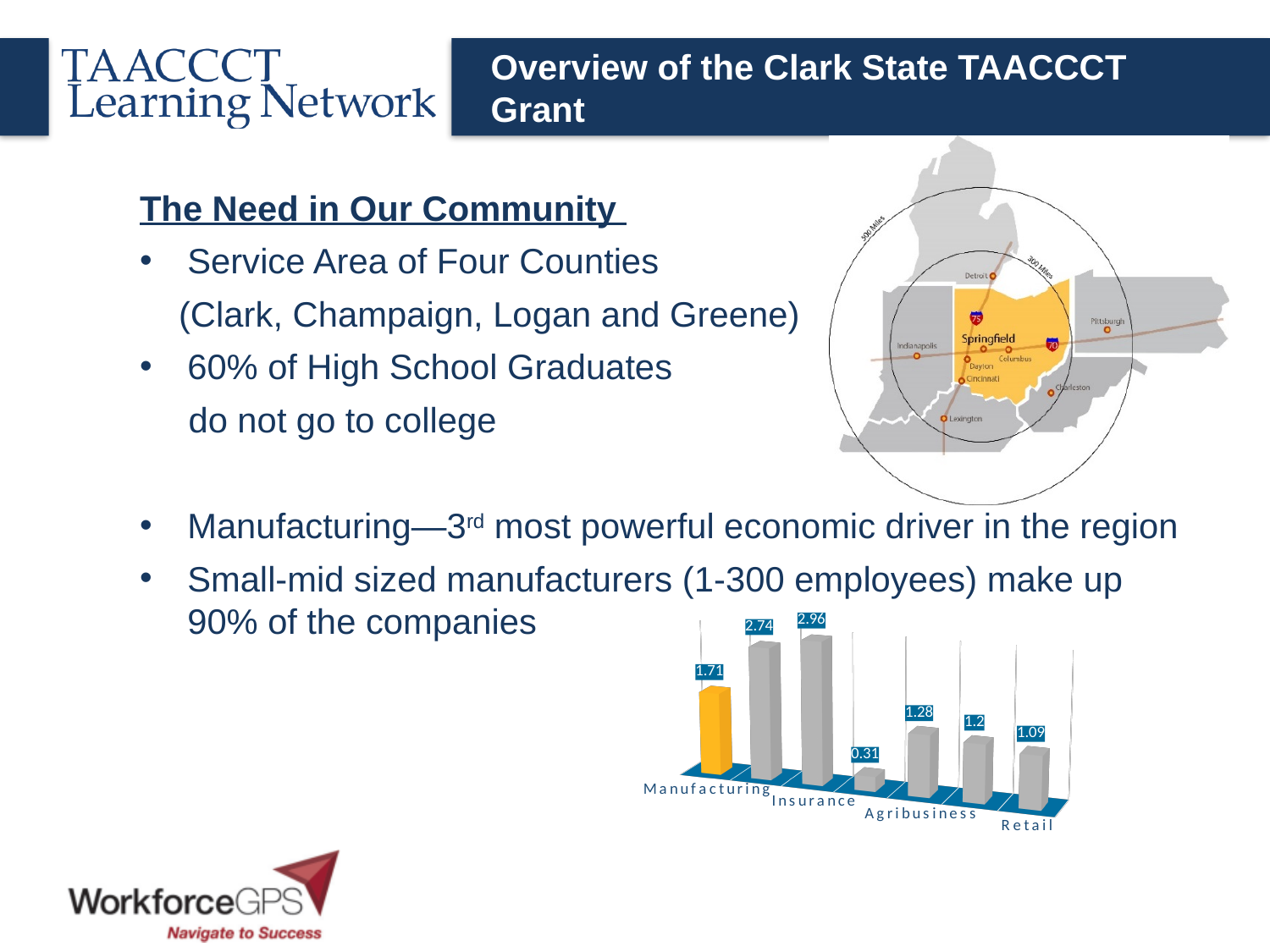
What kind of chart is shown at the bottom right of the slide? Bar chart What is the highest value labelled on any bar in the chart? 2.96 What is the value shown for Manufacturing in the bar chart? 1.71 Which has the larger value, Manufacturing or Retail? Manufacturing What is the difference between the highest bar value (2.96) and the lowest bar value (0.31)? 2.65 What is the value shown for Retail in the bar chart? 1.09 How many bars are plotted in the chart? 7 What colour is the Manufacturing bar in the chart? Yellow What is the lowest value labelled on any bar in the chart? 0.31 What is the difference between the Manufacturing value and the Retail value? 0.62 Which category label appears first on the left of the chart's x axis? Manufacturing